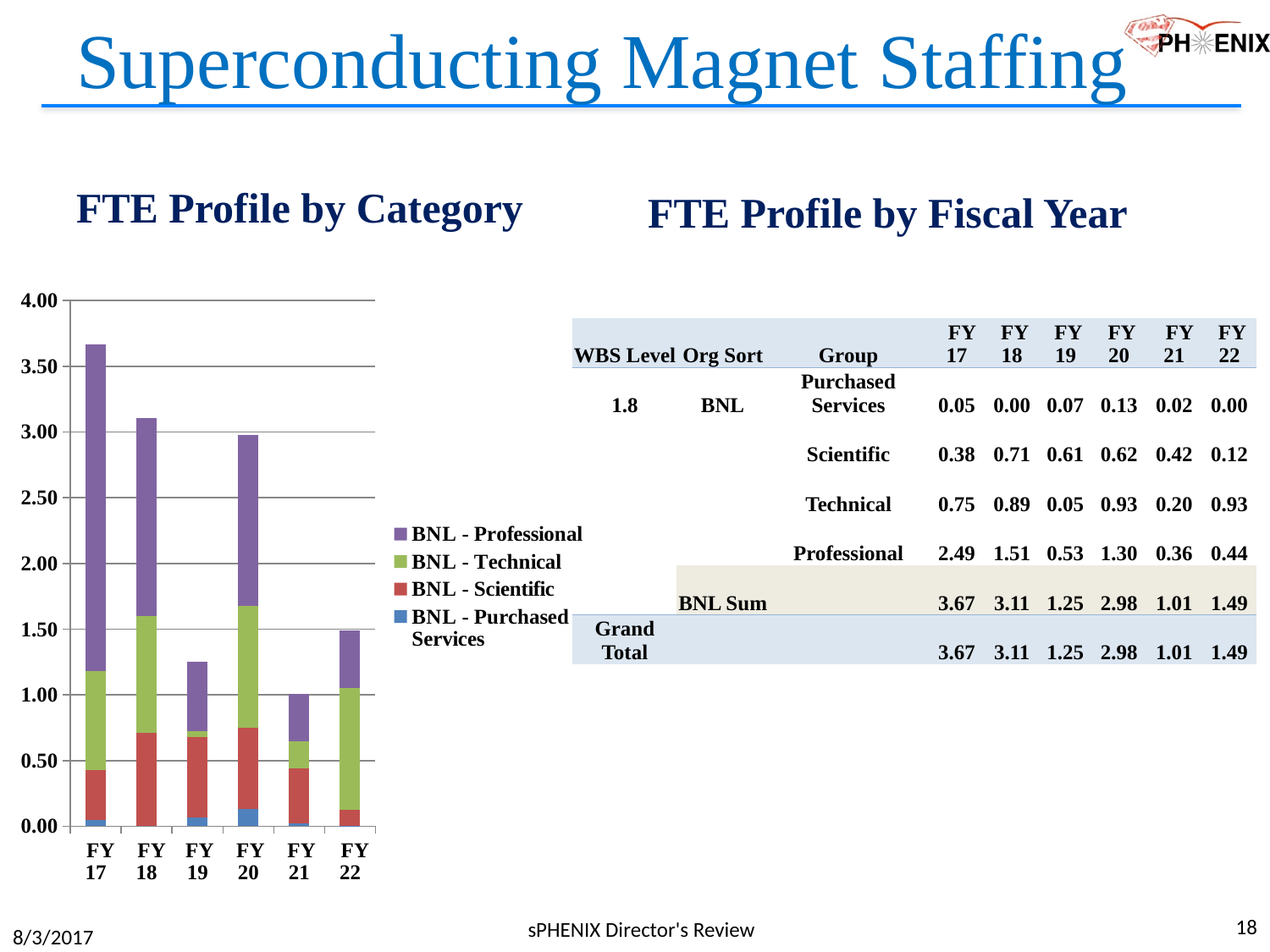
In the FTE Profile by Category chart, does the total stacked bar rise or fall from FY 17 to FY 18? fall In the FTE Profile by Category chart, is the total stacked bar for FY 22 greater or less than 2.00? less In the FTE Profile by Category chart, is the total stacked bar for FY 17 greater or less than 3.50? greater In the FTE Profile by Category chart, which fiscal year has the shortest stacked bar? FY 21 In the FTE Profile by Category chart, is the total stacked bar for FY 19 greater or less than 1.50? less In the FTE Profile by Category chart, which series is shown in purple according to the legend? BNL - Professional What kind of chart is shown under the heading "FTE Profile by Category"? Stacked bar chart In the FTE Profile by Category chart, which fiscal year has the tallest stacked bar? FY 17 In the FTE Profile by Category chart, which series is shown in green according to the legend? BNL - Technical How many fiscal years are shown on the x axis of the FTE Profile by Category chart? 6 How many series does the legend of the FTE Profile by Category chart list? 4 In the FTE Profile by Category chart, which stacked bar is taller, FY 19 or FY 21? FY 19